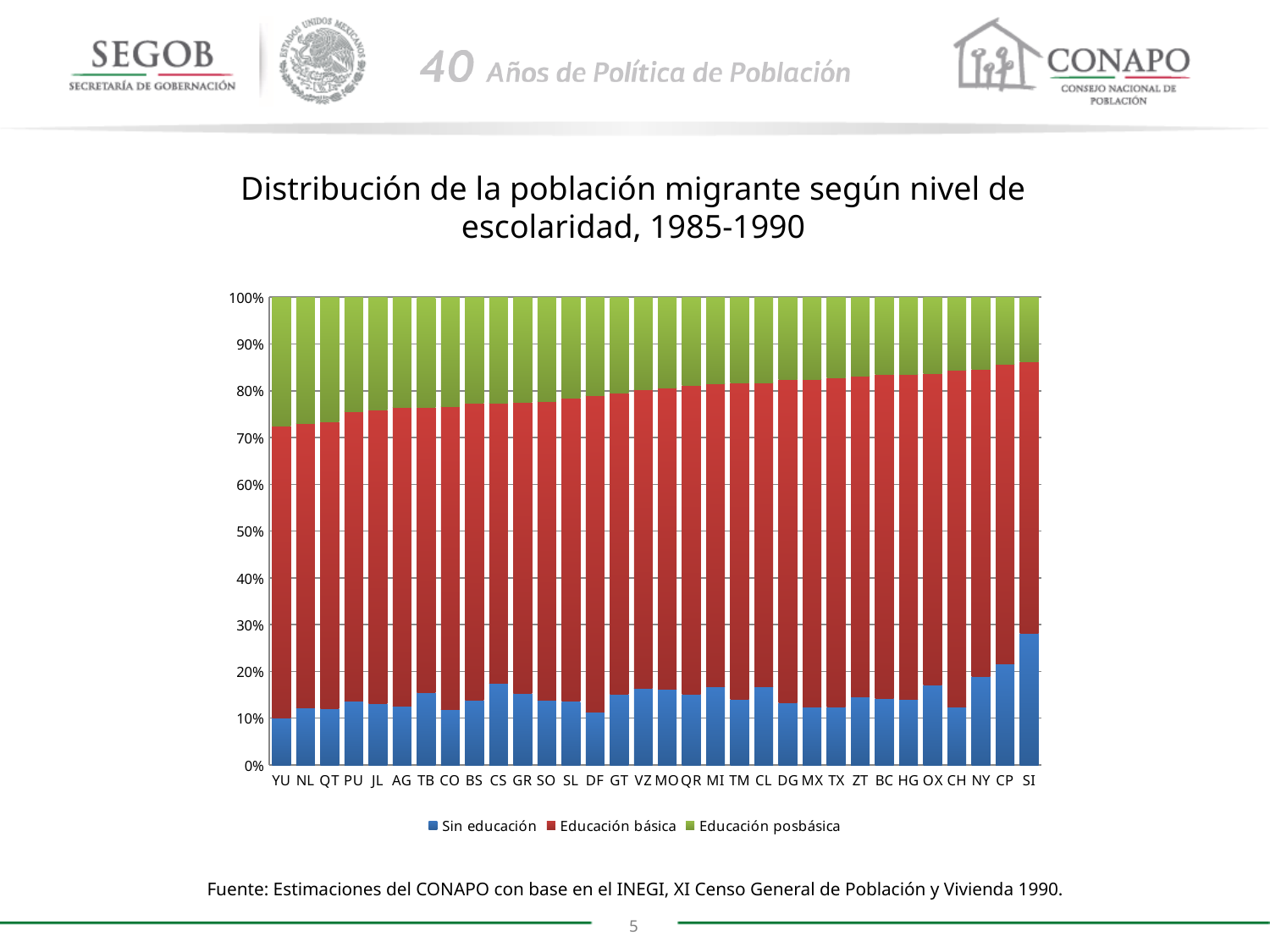
Which category has the smallest share of 'Educación posbásica'? SI Is the 'Educación posbásica' share for YU greater or less than 20%? greater Is the 'Sin educación' share for SI greater or less than 20%? greater Which category has the largest share of 'Educación posbásica'? YU What kind of chart is shown on the slide? Stacked bar chart What is the title of the chart? Distribución de la población migrante según nivel de escolaridad, 1985-1990 Which has a larger 'Sin educación' share, SI or YU? SI Which category has the largest share of 'Sin educación'? SI Moving from left to right along the x axis, does the share of 'Educación posbásica' rise or fall? fall How many categories (states) are shown on the x axis? 32 Is the 'Sin educación' share for YU greater or less than 20%? less How many series does the legend list? 3